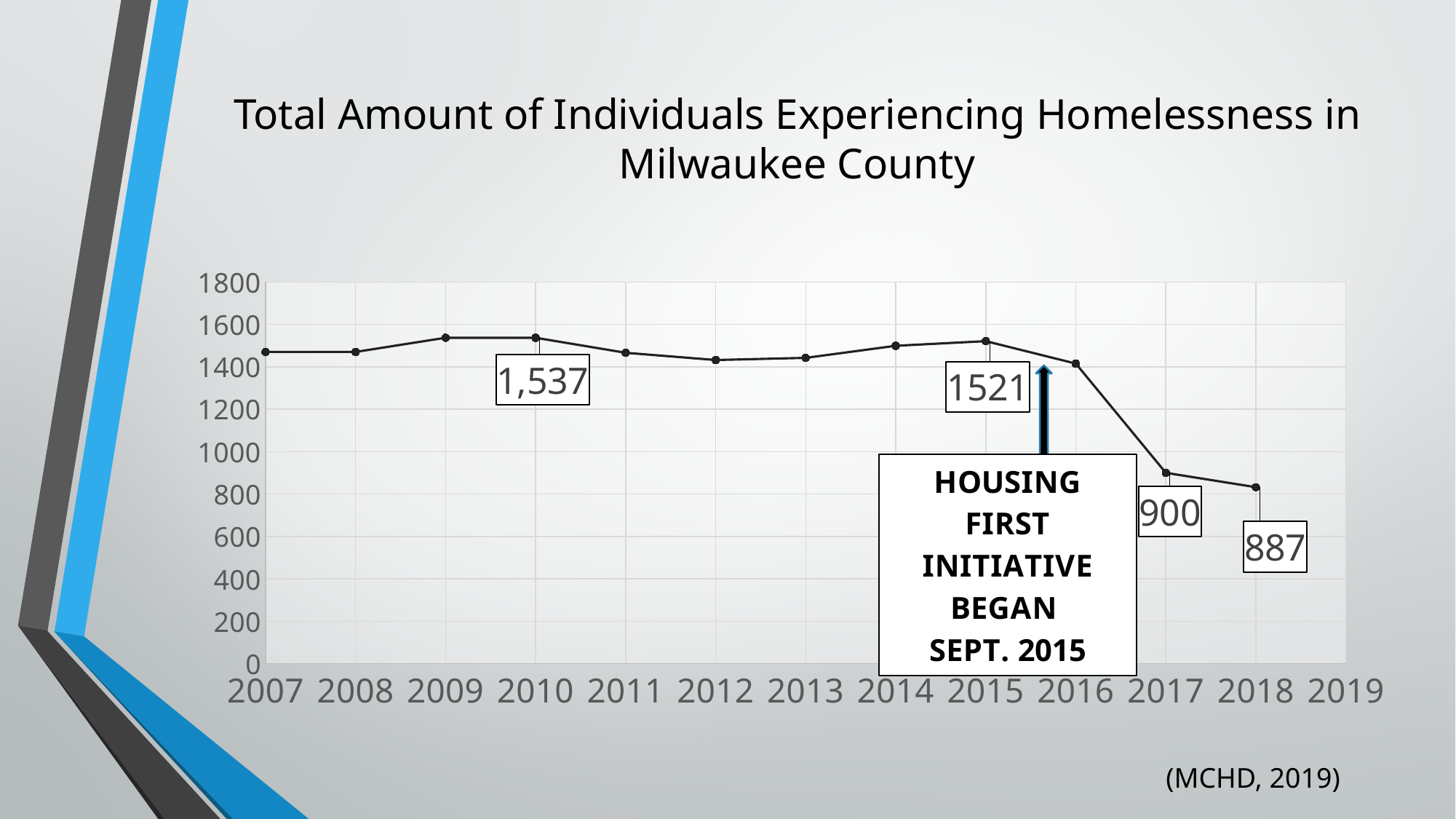
What is the value for 2017? 900 Do the values rise or fall from 2015 to 2018? fall What is the difference between the values for 2017 and 2018? 13 Is the value for 2016 greater or less than 1600? less Which is larger, the value for 2010 or the value for 2015? 2010 What is the difference between the values for 2010 and 2015? 16 What kind of chart is shown on the slide? line chart Which year has the lowest value on the chart? 2018 What is the value for 2015? 1521 What is the value for 2018? 887 Is the value for 2012 greater or less than 1200? greater What is the value for 2010? 1,537